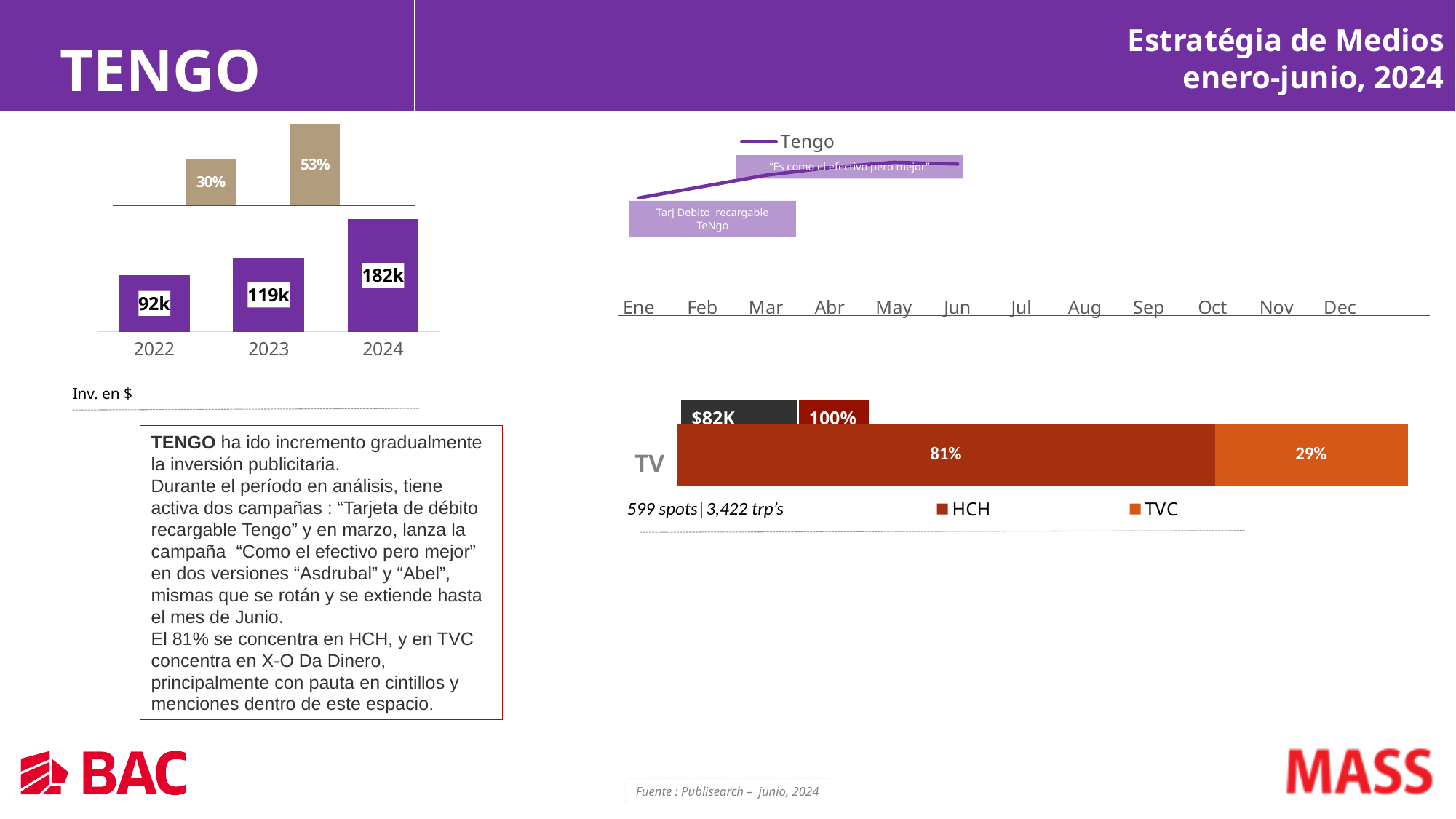
In the bar chart on the left (Inv. en $), what is the value for 2024? 182k In the bar chart on the left (Inv. en $), how many years are shown? 3 In the bar chart on the left (Inv. en $), what is the percentage growth shown between 2023 and 2024? 53% In the TV stacked bar chart on the right, what is the share for HCH? 81% In the bar chart on the left (Inv. en $), what is the difference between the 2024 and 2022 values? 90k In the TV stacked bar chart on the right, which is larger, HCH or TVC? HCH In the bar chart on the left (Inv. en $), which year has the highest investment? 2024 In the bar chart on the left (Inv. en $), do the investment values rise or fall from 2022 to 2024? rise In the bar chart on the left (Inv. en $), what is the value for 2022? 92k In the bar chart on the left (Inv. en $), which year has the lowest investment? 2022 In the TV stacked bar chart on the right, how many series does the legend list? 2 In the timeline chart on the right, how many months are shown on the x axis? 12